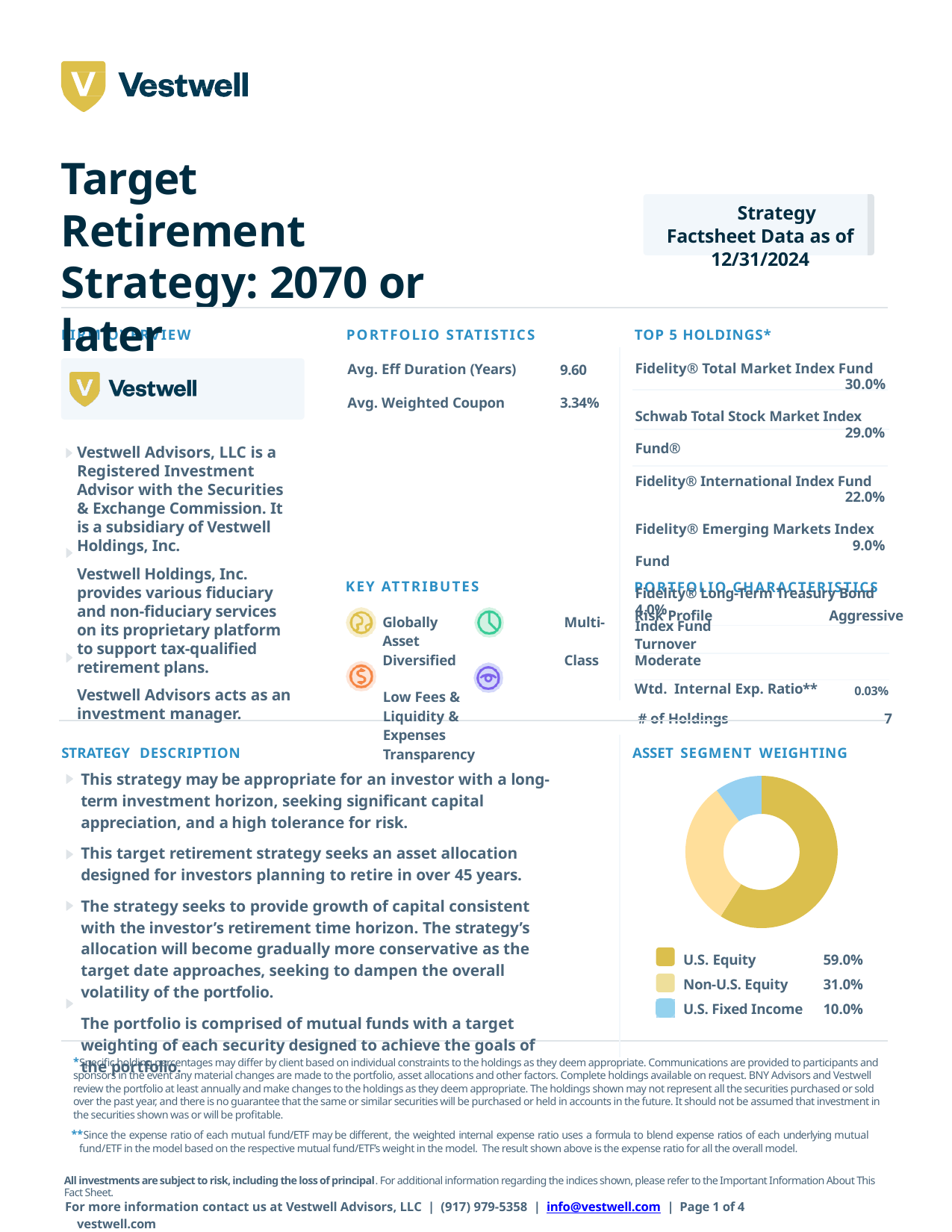
In the Asset Segment Weighting chart, what colour represents U.S. Fixed Income? Light blue In the Asset Segment Weighting chart, what is the difference between U.S. Equity and Non-U.S. Equity? 28.0% How many segments does the Asset Segment Weighting chart show? 3 In the Asset Segment Weighting chart, what is the value for Non-U.S. Equity? 31.0% In the Asset Segment Weighting chart, which is larger: Non-U.S. Equity or U.S. Fixed Income? Non-U.S. Equity In the Asset Segment Weighting chart, what is the value for U.S. Equity? 59.0% Which segment has the smallest share in the Asset Segment Weighting chart? U.S. Fixed Income Which segment has the largest share in the Asset Segment Weighting chart? U.S. Equity What is the title of the chart on the slide? Asset Segment Weighting In the Asset Segment Weighting chart, what is the value for U.S. Fixed Income? 10.0% In the Asset Segment Weighting chart, what share of the pie does U.S. Equity represent? 59.0% What kind of chart is the Asset Segment Weighting chart? Pie chart (donut)